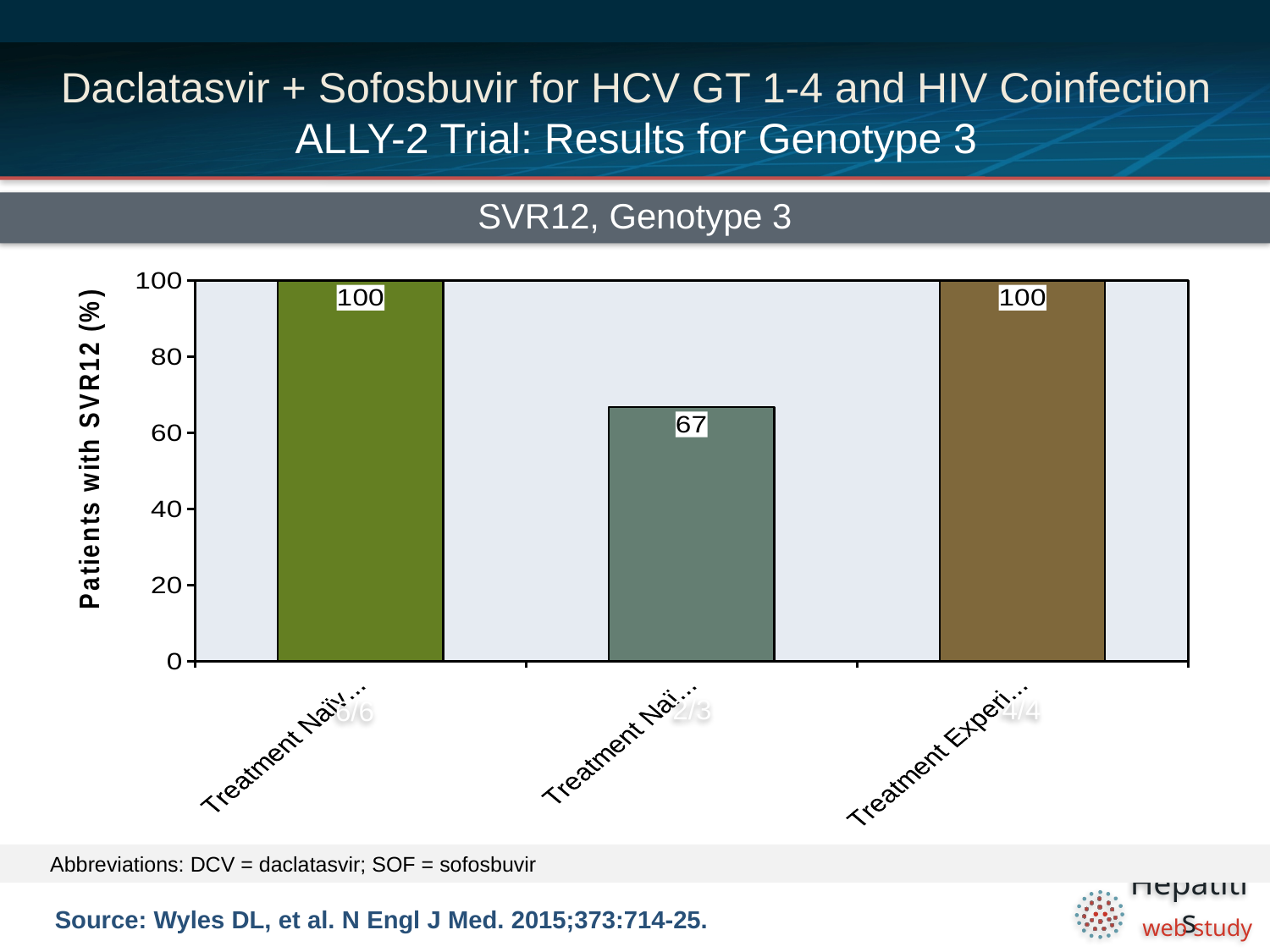
What is the difference between the leftmost bar and the middle bar? 33 What is the value of the middle bar? 67 What is the title of the chart? SVR12, Genotype 3 Which is larger, the middle bar or the rightmost bar? the rightmost bar Is the value of the middle bar greater or less than 80? less How many bars are plotted in the chart? 3 What is the value of the rightmost bar (Treatment Experi...)? 100 What is the label of the y-axis? Patients with SVR12 (%) What is the maximum value shown on the y-axis? 100 Which bar has the lowest value? the middle bar What is the value of the leftmost bar? 100 What type of chart is shown on the slide? bar chart